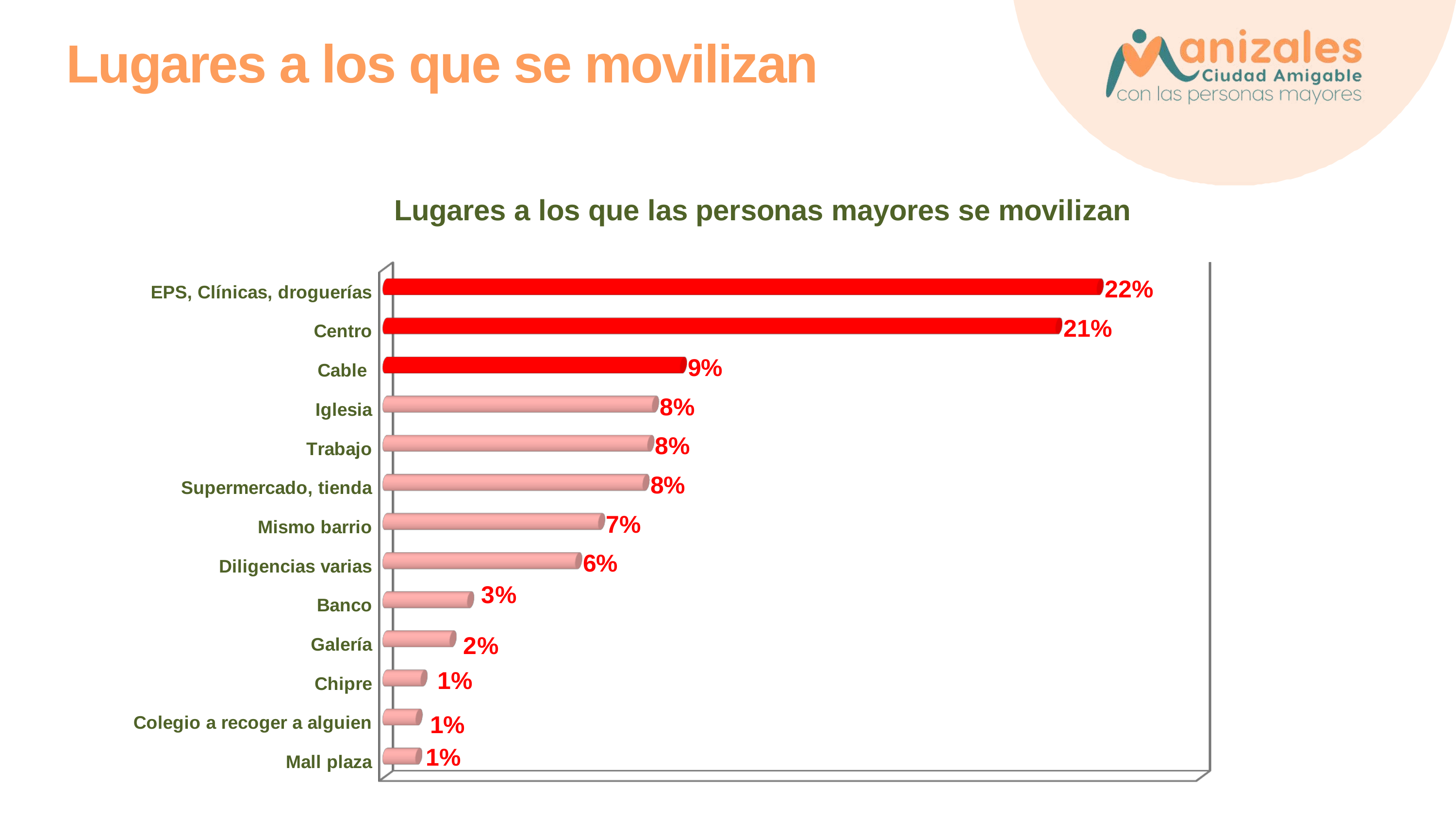
Which is larger, the value for Banco or the value for Diligencias varias? Diligencias varias What is the title of the chart? Lugares a los que las personas mayores se movilizan What is the value for Diligencias varias? 6% Which category has the highest value? EPS, Clínicas, droguerías What kind of chart is shown on the slide? Bar chart What is the difference between the values for Mismo barrio and Galería? 5% Which is larger, the value for Cable or the value for Iglesia? Cable How many categories are shown in the chart? 13 What is the difference between the values for EPS, Clínicas, droguerías and Cable? 13% What is the value for Centro? 21% What is the value for Banco? 3% What is the value for Cable? 9%